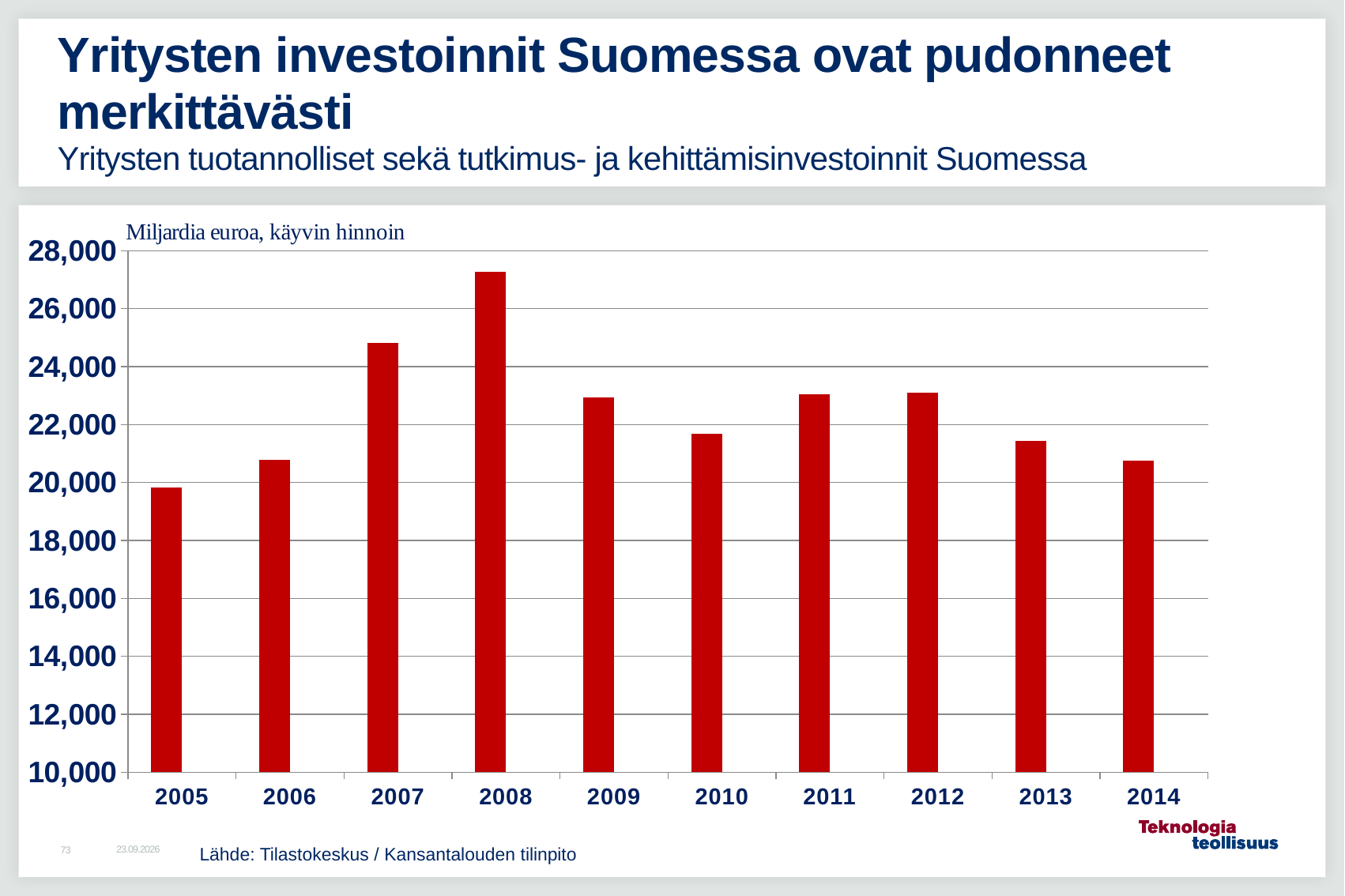
Is the value for 2008 greater or less than 26,000? greater Which year has the lowest value in the chart? 2005 What kind of chart is shown on the slide? Bar chart Is the value for 2013 greater or less than 22,000? less Which year has the highest value in the chart? 2008 Do the values rise or fall from 2008 to 2010? fall Which year has the larger value, 2007 or 2009? 2007 How many years are shown on the x axis of the chart? 10 Is the value for 2007 greater or less than 24,000? greater What unit label is shown above the chart's y axis? Miljardia euroa, käyvin hinnoin